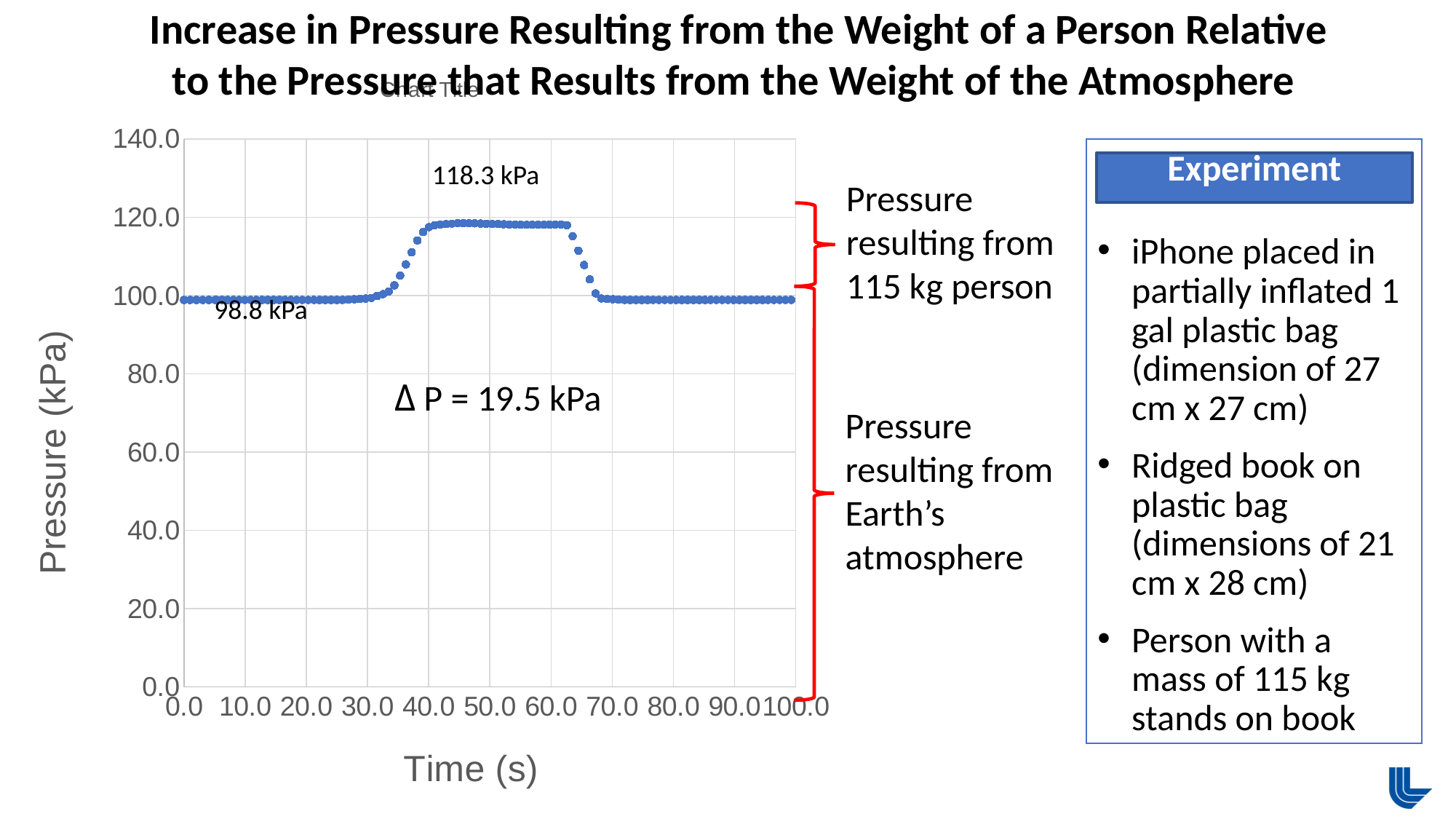
What is the difference between the plateau pressure and the baseline pressure shown on the chart? 19.5 kPa Between 30 s and 40 s, does the pressure rise or fall? rise Between 60 s and 70 s, does the pressure rise or fall? fall What pressure value is labelled on the raised plateau of the chart? 118.3 kPa Is the pressure at 50 s greater or less than 100? greater Which is larger, the pressure at 50 s or the pressure at 10 s? the pressure at 50 s What is the label of the x axis of the chart? Time (s) What pressure value is labelled on the baseline portion of the chart? 98.8 kPa Is the pressure at 80 s greater or less than 80? greater Is the pressure at 50 s greater or less than 120? less What type of chart is shown on the slide? scatter chart What is the label of the y axis of the chart? Pressure (kPa)